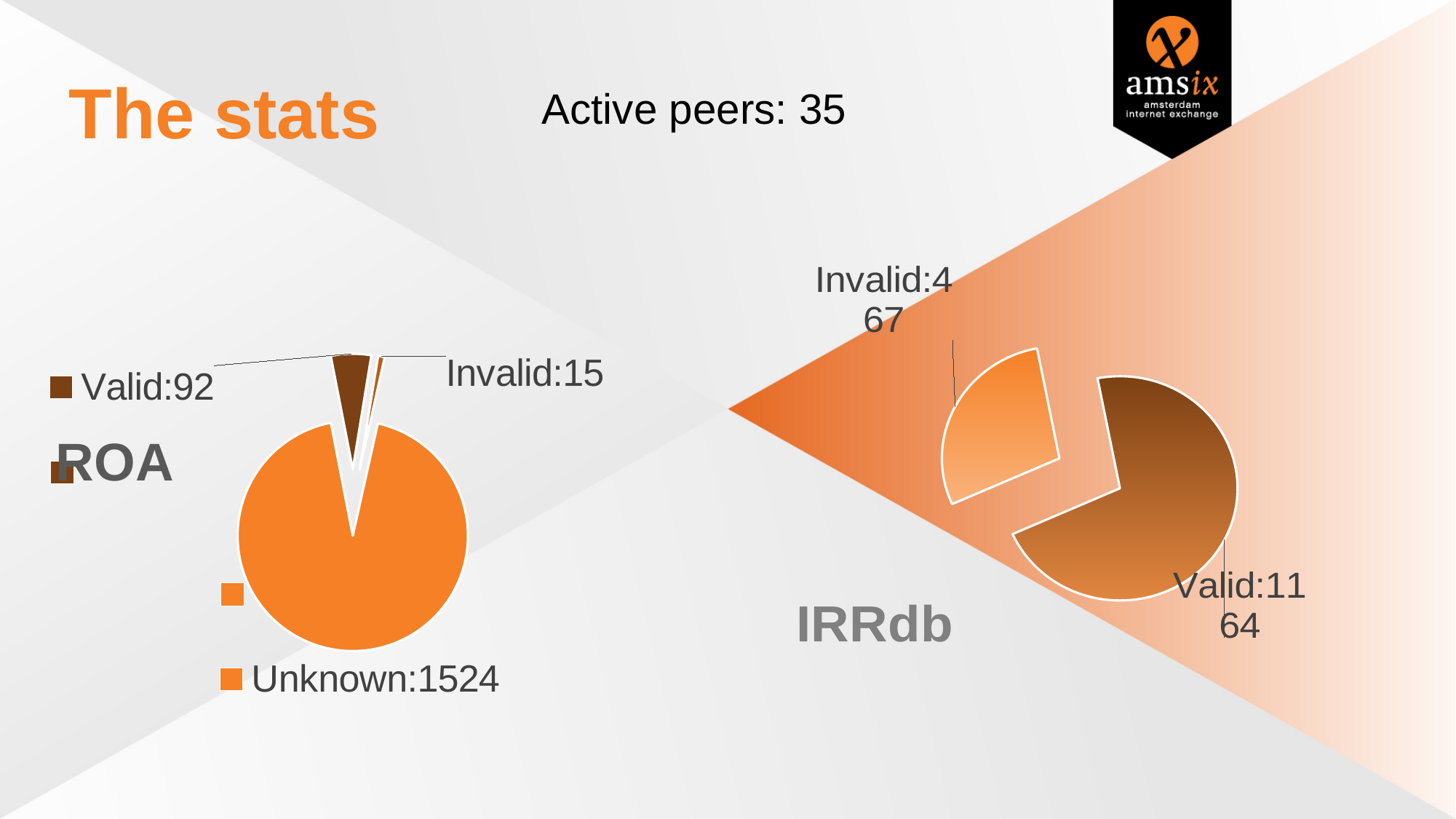
In the ROA chart, which category has the largest value? Unknown In the ROA chart, what is the difference between the Valid and Invalid values? 77 In the ROA chart, what is the value for Valid? 92 How many categories does the ROA chart show? 3 In the ROA chart, what is the value for Invalid? 15 What kind of chart is the ROA chart on the left? pie chart In the IRRdb chart, what is the value for Invalid? 467 In the ROA chart, what is the value for Unknown? 1524 In the IRRdb chart, what is the value for Valid? 1164 In the IRRdb chart, what is the difference between the Valid and Invalid values? 697 In the ROA chart, which category has the smallest value? Invalid In the IRRdb chart, which is larger, Valid or Invalid? Valid